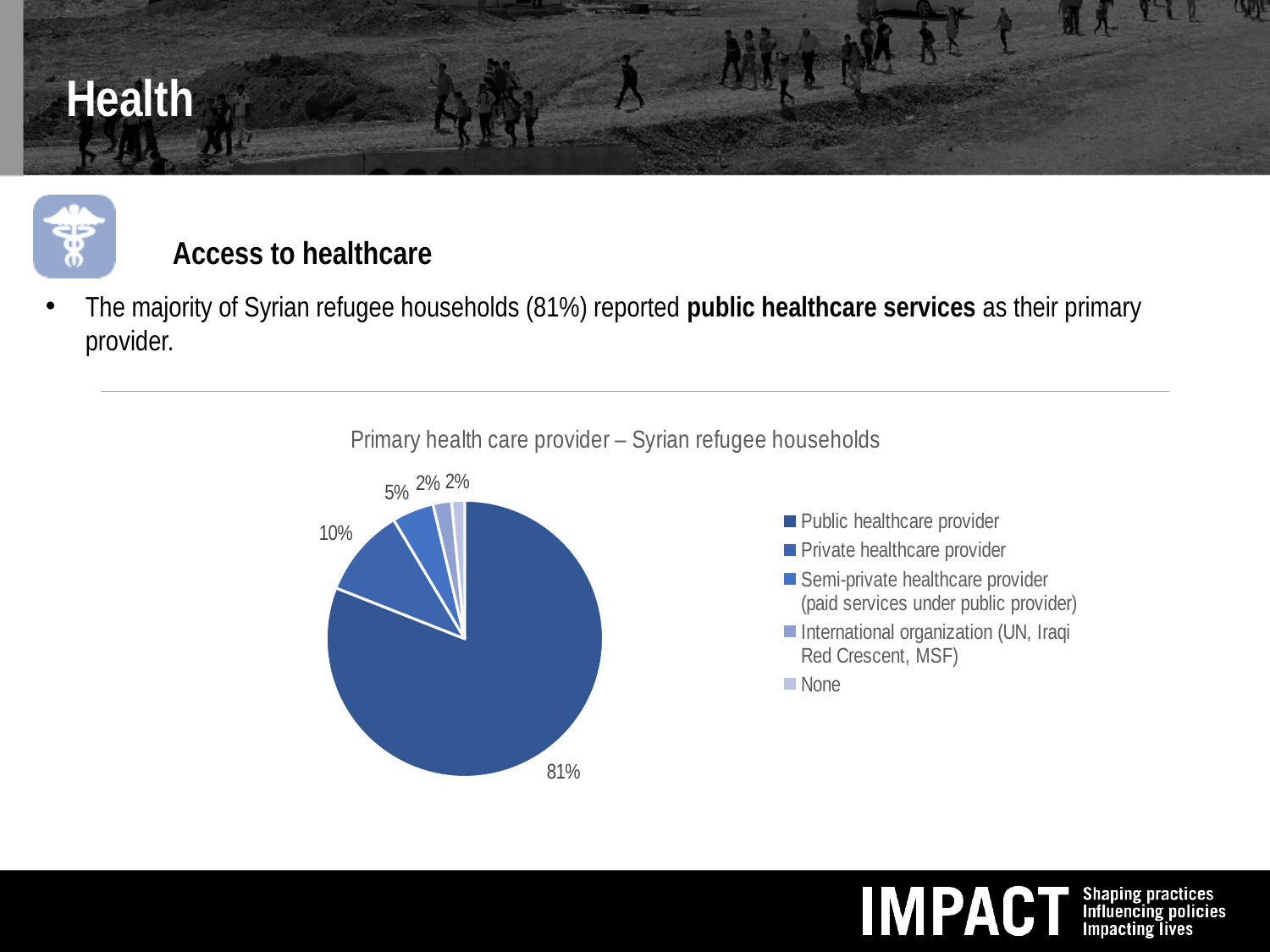
What percentage of households reported no primary health care provider (None)? 2% What percentage of households reported a private healthcare provider as their primary provider? 10% What percentage of households reported an international organization (UN, Iraqi Red Crescent, MSF) as their primary provider? 2% What is the title of the chart? Primary health care provider – Syrian refugee households What share of Syrian refugee households reported a public healthcare provider as their primary health care provider? 81% What share of the pie is the semi-private healthcare provider (paid services under public provider)? 5% What is the difference in percentage points between the public healthcare provider share and the private healthcare provider share? 71 percentage points Which primary health care provider category has the largest share of the pie? Public healthcare provider Which is larger: the share for private healthcare provider or the share for semi-private healthcare provider? Private healthcare provider What is the combined share of the private and semi-private healthcare provider slices? 15% How many categories does the pie chart show? 5 What type of chart is shown on the slide? Pie chart